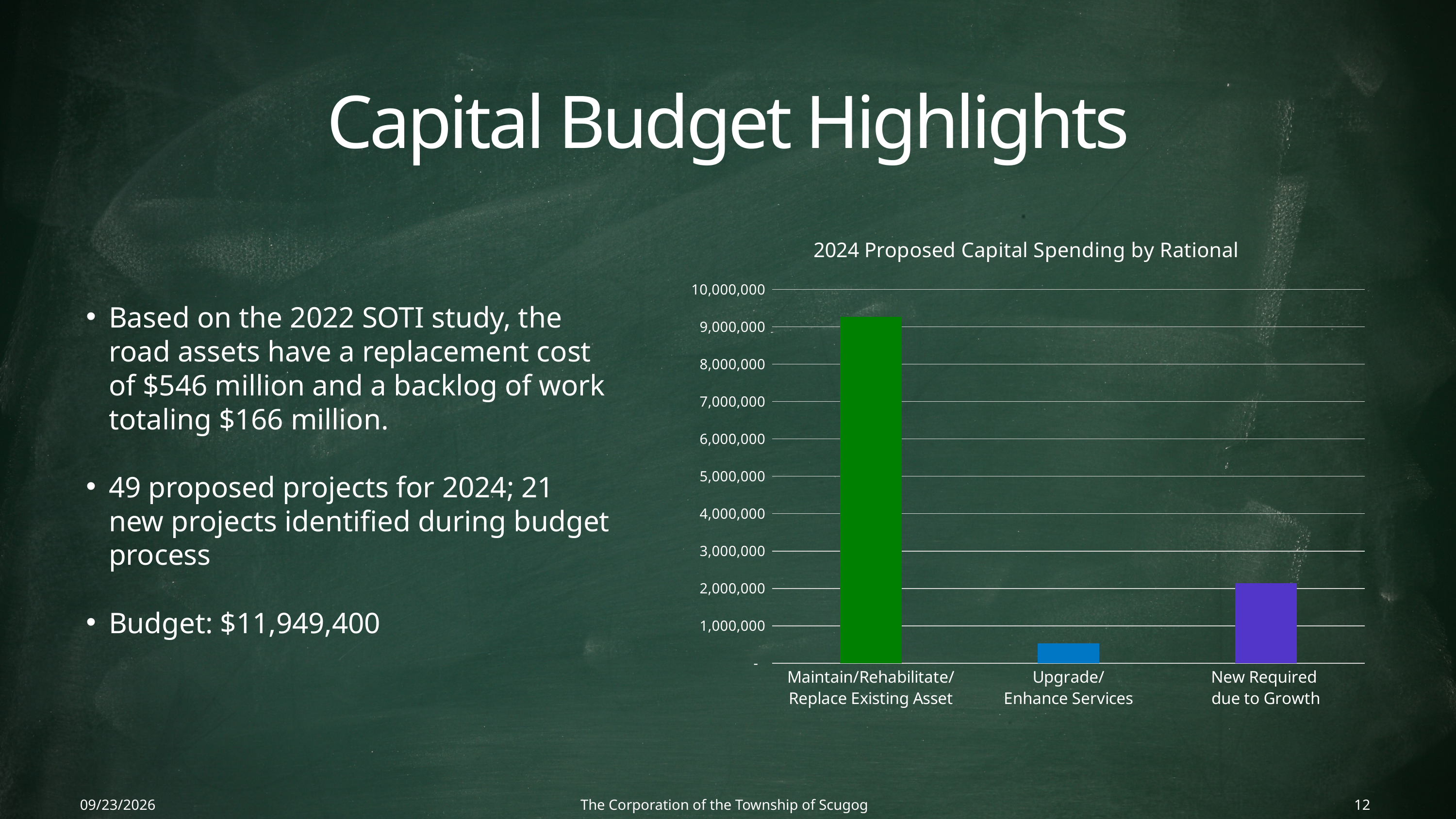
What is the highest value shown on the vertical axis of the chart? 10,000,000 Which is larger, the value for New Required due to Growth or the value for Upgrade/Enhance Services? New Required due to Growth Which category has the lowest proposed capital spending? Upgrade/Enhance Services Is the value for Upgrade/Enhance Services greater or less than 1,000,000? less What kind of chart is shown on the slide? bar chart What is the title of the chart? 2024 Proposed Capital Spending by Rational How many categories are plotted in the chart? 3 Is the value for New Required due to Growth greater or less than 2,000,000? greater Is the value for New Required due to Growth greater or less than 3,000,000? less Which category has the highest proposed capital spending? Maintain/Rehabilitate/Replace Existing Asset